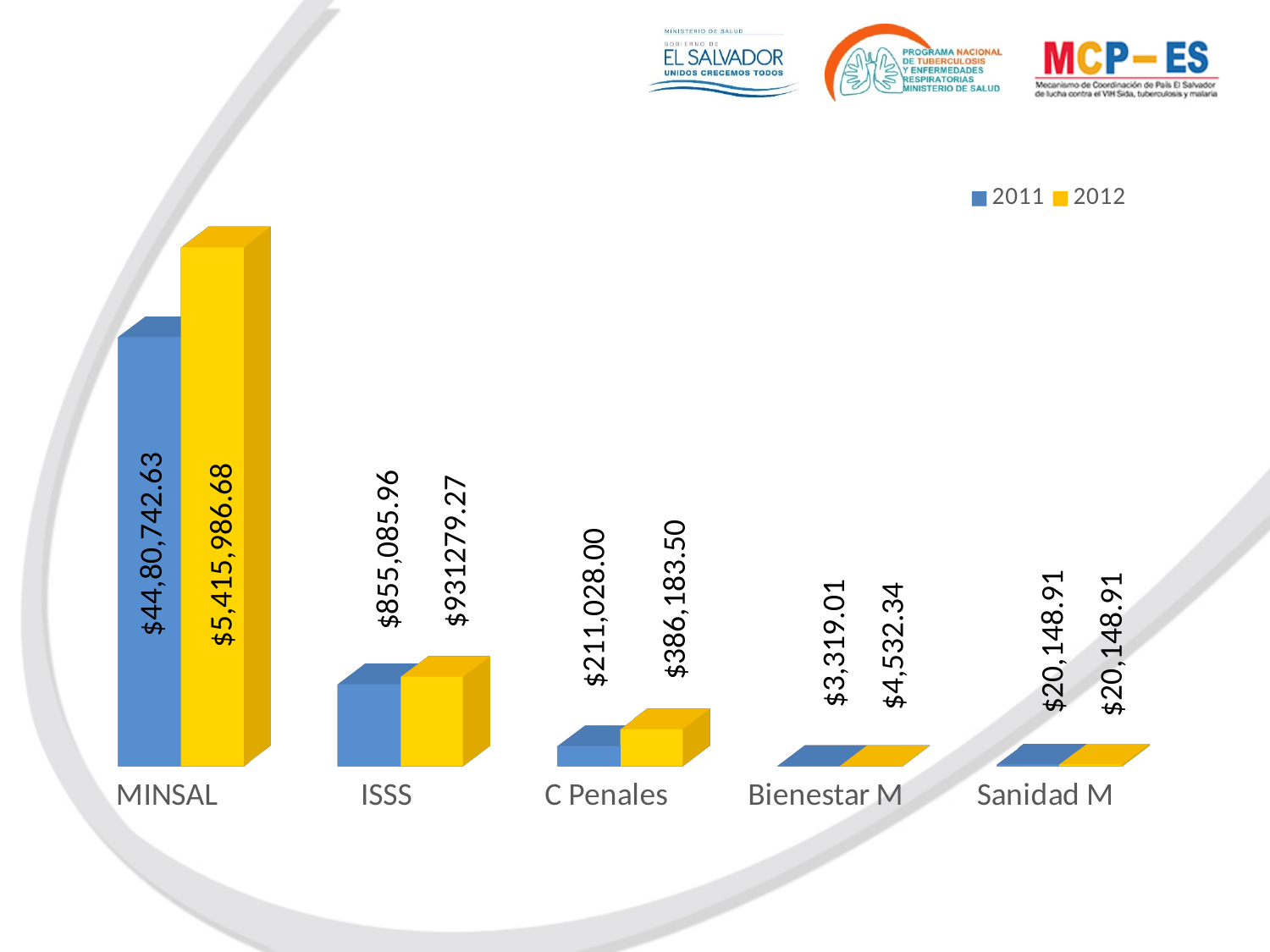
Which is larger: the 2011 value for ISSS or the 2012 value for C Penales? The 2011 value for ISSS What is the value for Bienestar M in 2011? $3,319.01 What is the value for Sanidad M in 2012? $20,148.91 What is the difference between the 2012 and 2011 values for C Penales? $175,155.50 What is the value for ISSS in 2011? $855,085.96 Which category has the highest value in 2012? MINSAL What is the value for C Penales in 2012? $386,183.50 How many categories are shown on the x axis? 5 What is the value for MINSAL in 2012? $5,415,986.68 How many series does the legend list? 2 What is the difference between the 2012 and 2011 values for Bienestar M? $1,213.33 Which category has the lowest value in 2011? Bienestar M